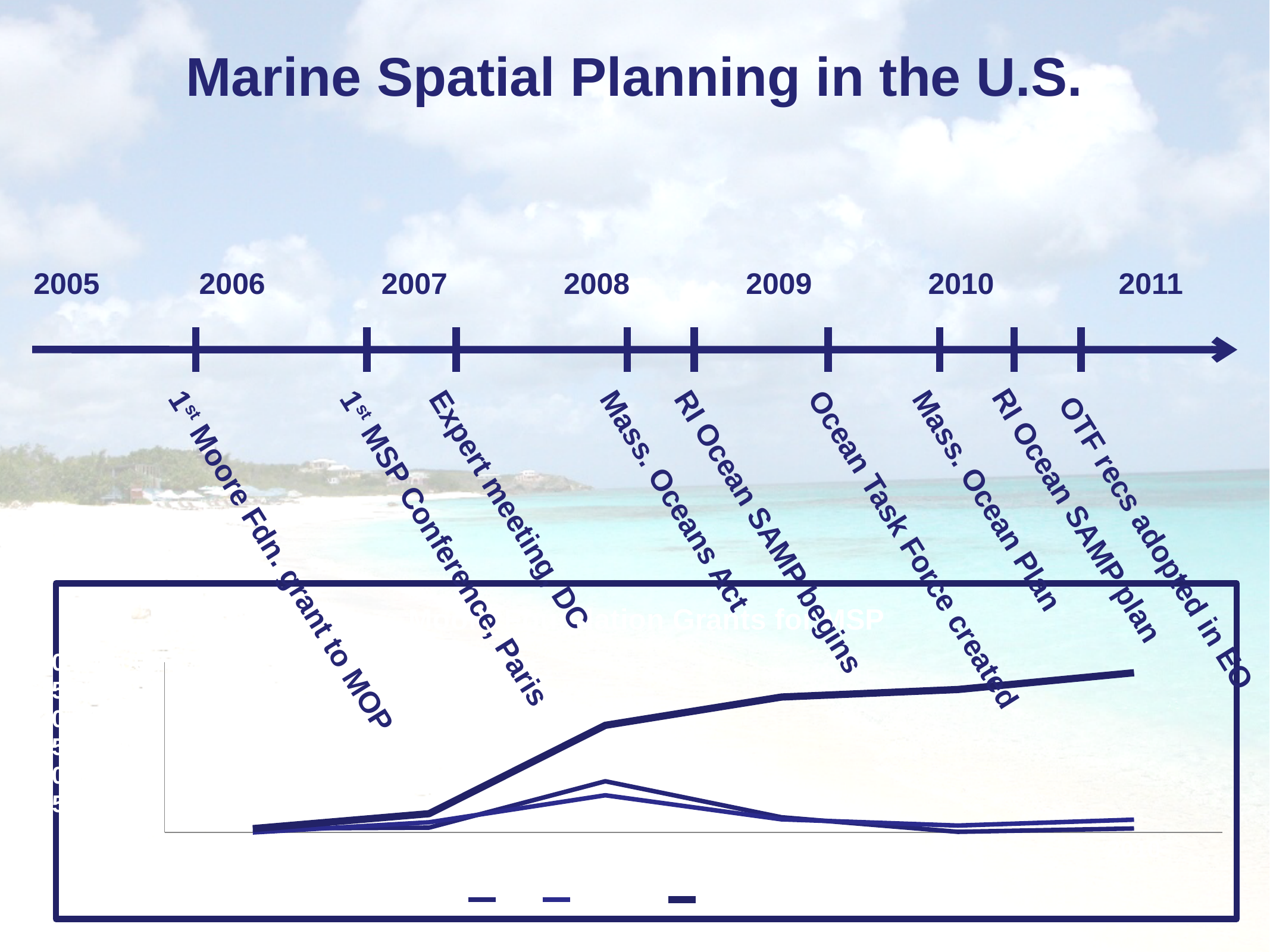
What kind of chart is shown in the box at the bottom of the slide? line chart Do the two thinner lines in the bottom chart peak in the middle of the x axis or at the right-hand end? in the middle At the right-hand end of the bottom chart, is the thickest line above or below the two thinner lines? above Does the thickest line in the bottom chart rise or fall from left to right? rise How many entries does the legend of the bottom chart show? 3 How many lines are plotted in the chart at the bottom of the slide? 3 How many data points does the thickest line in the bottom chart have? 6